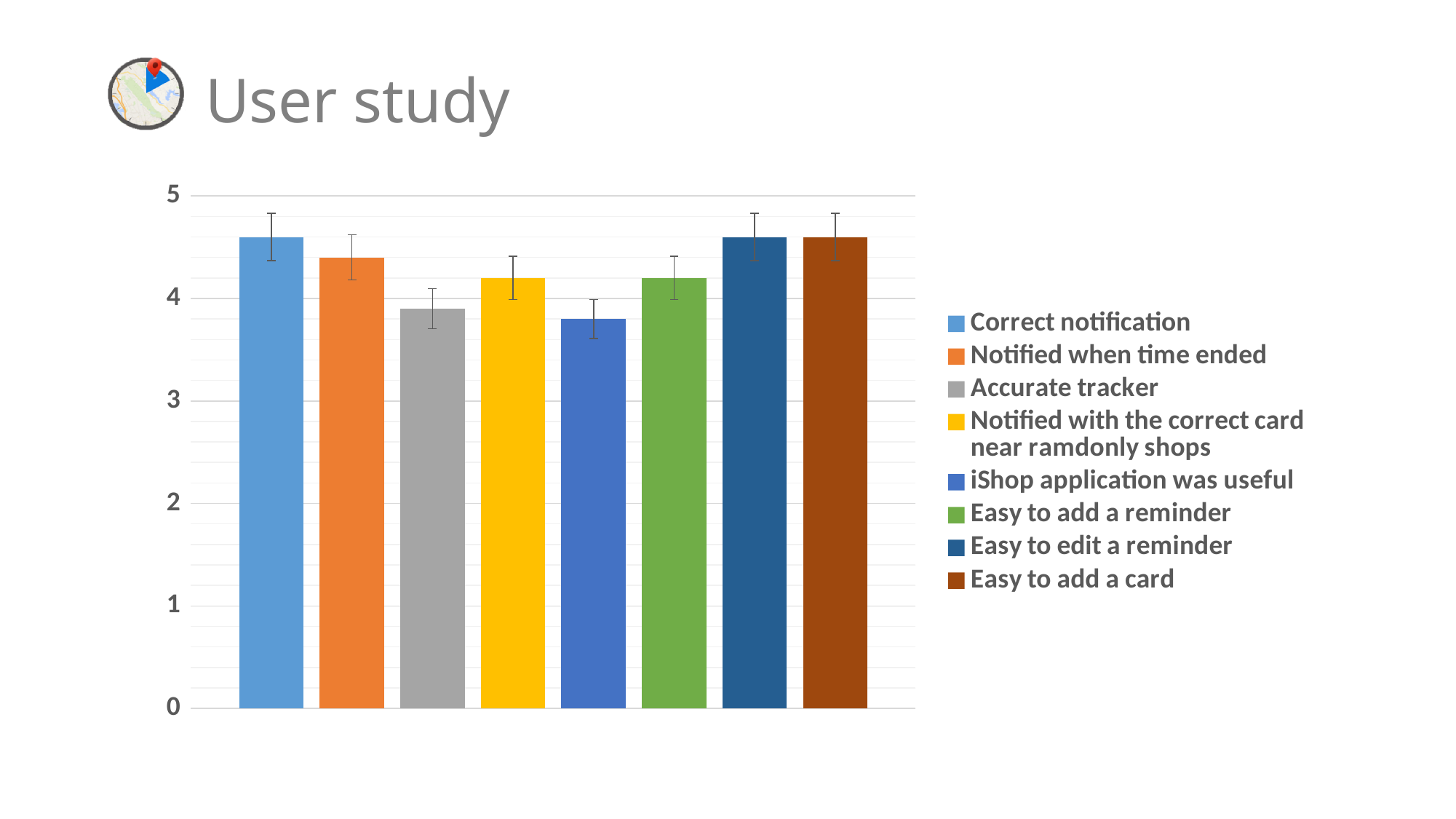
What is the highest value shown on the chart's vertical axis? 5 Which is larger, the value for iShop application was useful or the value for Easy to edit a reminder? Easy to edit a reminder How many entries does the chart's legend list? 8 Is the value for Notified when time ended greater or less than 4? greater How many bars are plotted in the chart? 8 What colour is the bar for Accurate tracker? gray Is the value for iShop application was useful greater or less than 4? less What kind of chart is shown on the slide? bar chart Is the value for Correct notification greater or less than 4? greater Which is larger, the value for Correct notification or the value for Accurate tracker? Correct notification